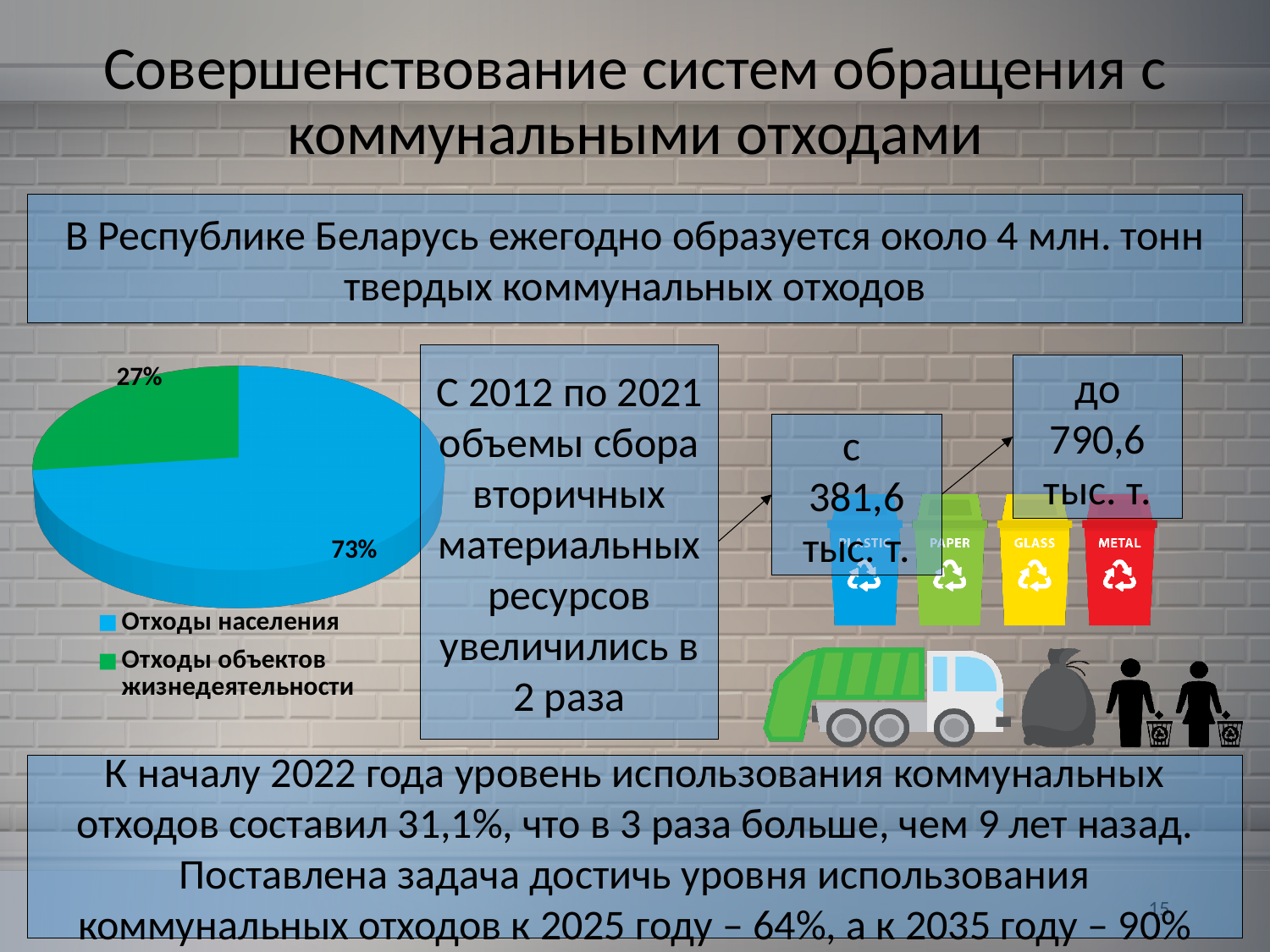
What colour is the slice for "Отходы населения" in the pie chart? blue What colour is the slice for "Отходы объектов жизнедеятельности" in the pie chart? green Which category has the largest slice in the pie chart? Отходы населения What kind of chart is shown on the left of the slide? pie chart What is the difference in percentage points between "Отходы населения" and "Отходы объектов жизнедеятельности"? 46 Which category has the smallest slice in the pie chart? Отходы объектов жизнедеятельности What share of the pie does "Отходы населения" represent? 73% How many entries does the legend of the pie chart list? 2 How many slices does the pie chart have? 2 Which is larger: the slice for "Отходы населения" or the slice for "Отходы объектов жизнедеятельности"? Отходы населения What is the total of the two slices shown in the pie chart? 100% What share of the pie does "Отходы объектов жизнедеятельности" represent? 27%